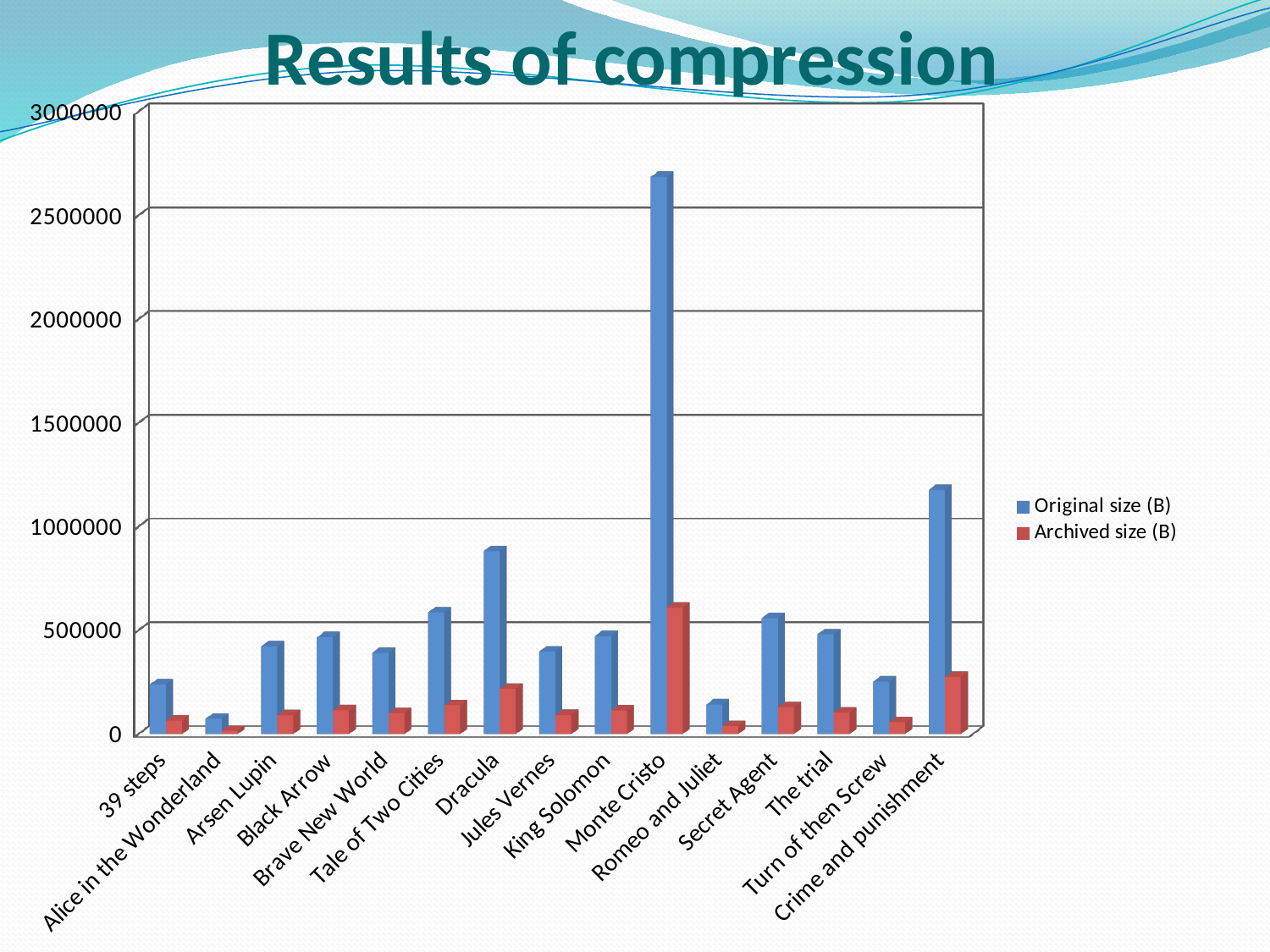
Is the Archived size (B) for Monte Cristo greater or less than 500000? greater How many series does the legend list? 2 What kind of chart is shown on the slide? bar chart How many book titles are shown on the x axis? 15 Which book has the highest Original size (B)? Monte Cristo Which has the larger Original size (B): Dracula or Crime and punishment? Crime and punishment What is the title of the chart? Results of compression Which book has the lowest Original size (B)? Alice in the Wonderland Is the Original size (B) for Monte Cristo greater or less than 2500000? greater Which book has the highest Archived size (B)? Monte Cristo Is the Original size (B) for Crime and punishment greater or less than 1000000? greater